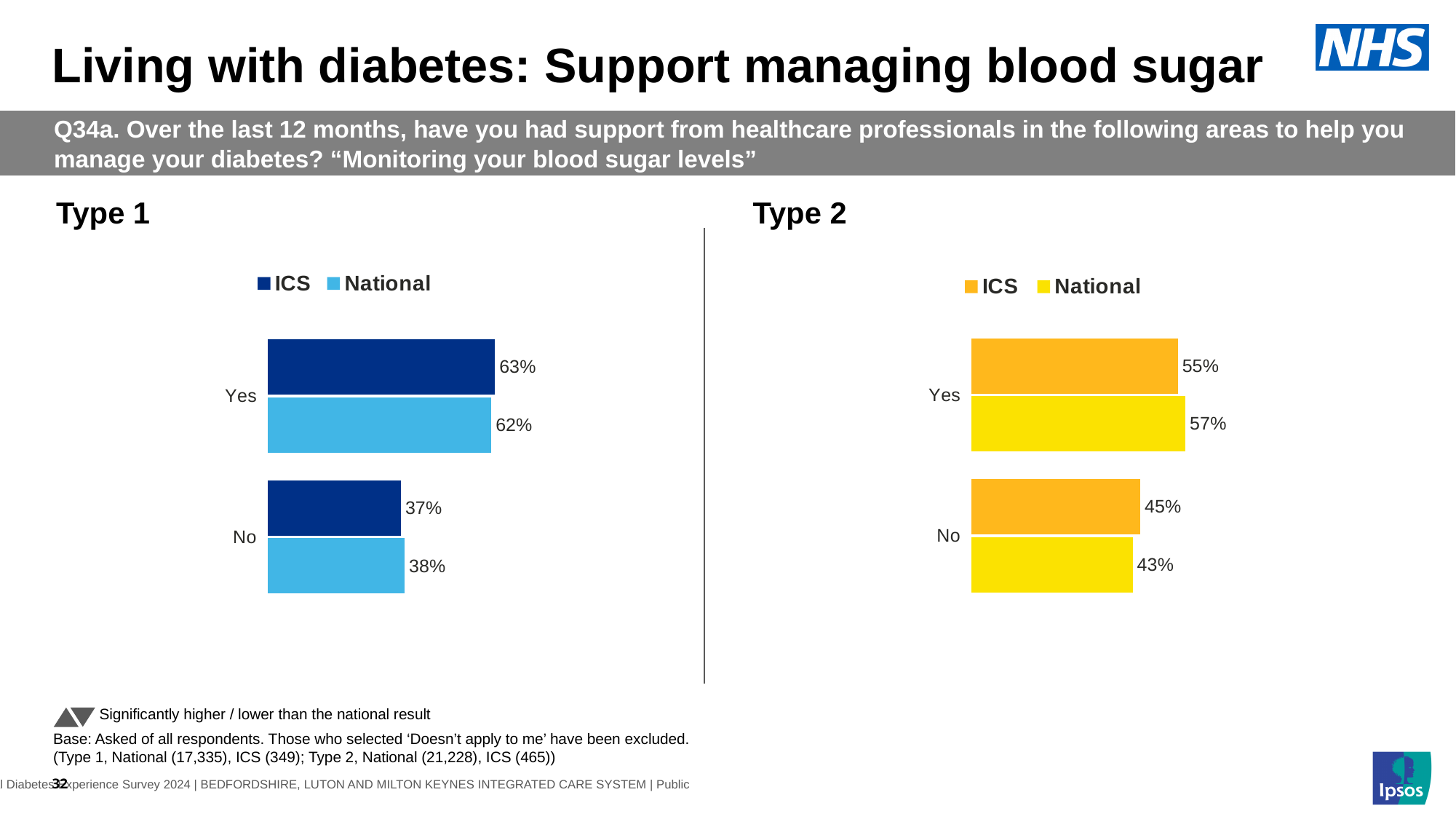
In the Type 2 chart, what is the ICS value for No? 45% In the Type 1 chart, what is the National value for No? 38% In the Type 2 chart, what is the difference between the National and ICS values for Yes? 2% How many series does the legend of the Type 1 chart list? 2 What kind of chart is the Type 1 chart? Bar chart In the Type 2 chart, which response category has the lowest National value? No In the Type 2 chart, which is larger for No: ICS or National? ICS In the Type 2 chart, what is the National value for Yes? 57% In the Type 1 chart, which response category has the highest ICS value? Yes In the Type 1 chart, what is the difference between the ICS values for Yes and No? 26% In the Type 1 chart, what is the ICS value for Yes? 63% How many response categories are shown in the Type 2 chart? 2